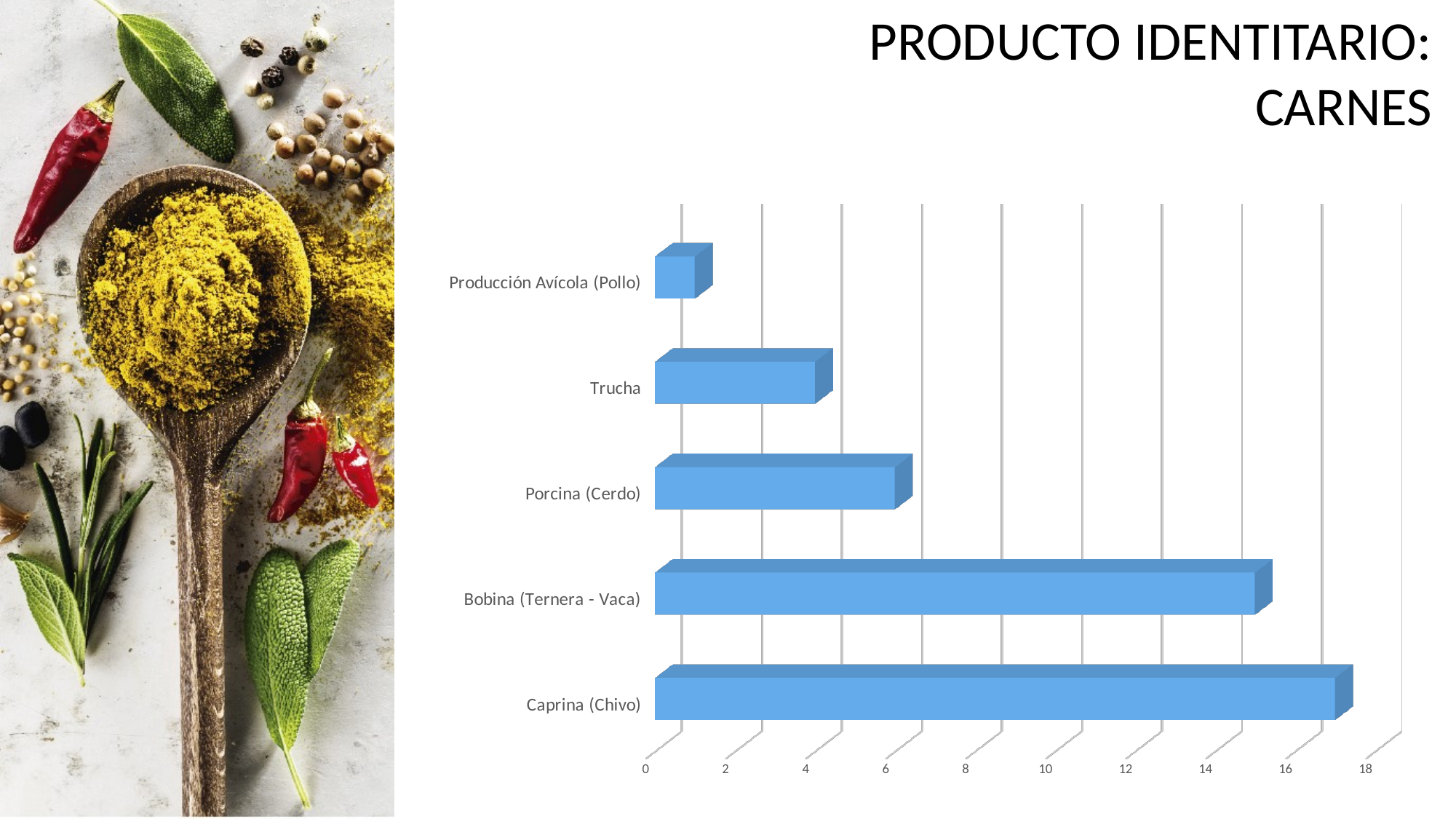
Is the value for Caprina (Chivo) greater or less than 16? greater Is the value for Bobina (Ternera - Vaca) greater or less than 14? greater Which category has the lowest value in the chart? Producción Avícola (Pollo) Which is larger, the value for Porcina (Cerdo) or the value for Trucha? Porcina (Cerdo) Is the value for Trucha greater or less than 6? less How many categories are shown in the chart? 5 What is the title of the slide containing the chart? PRODUCTO IDENTITARIO: CARNES Which category has the highest value in the chart? Caprina (Chivo) What kind of chart is shown on the slide? Bar chart